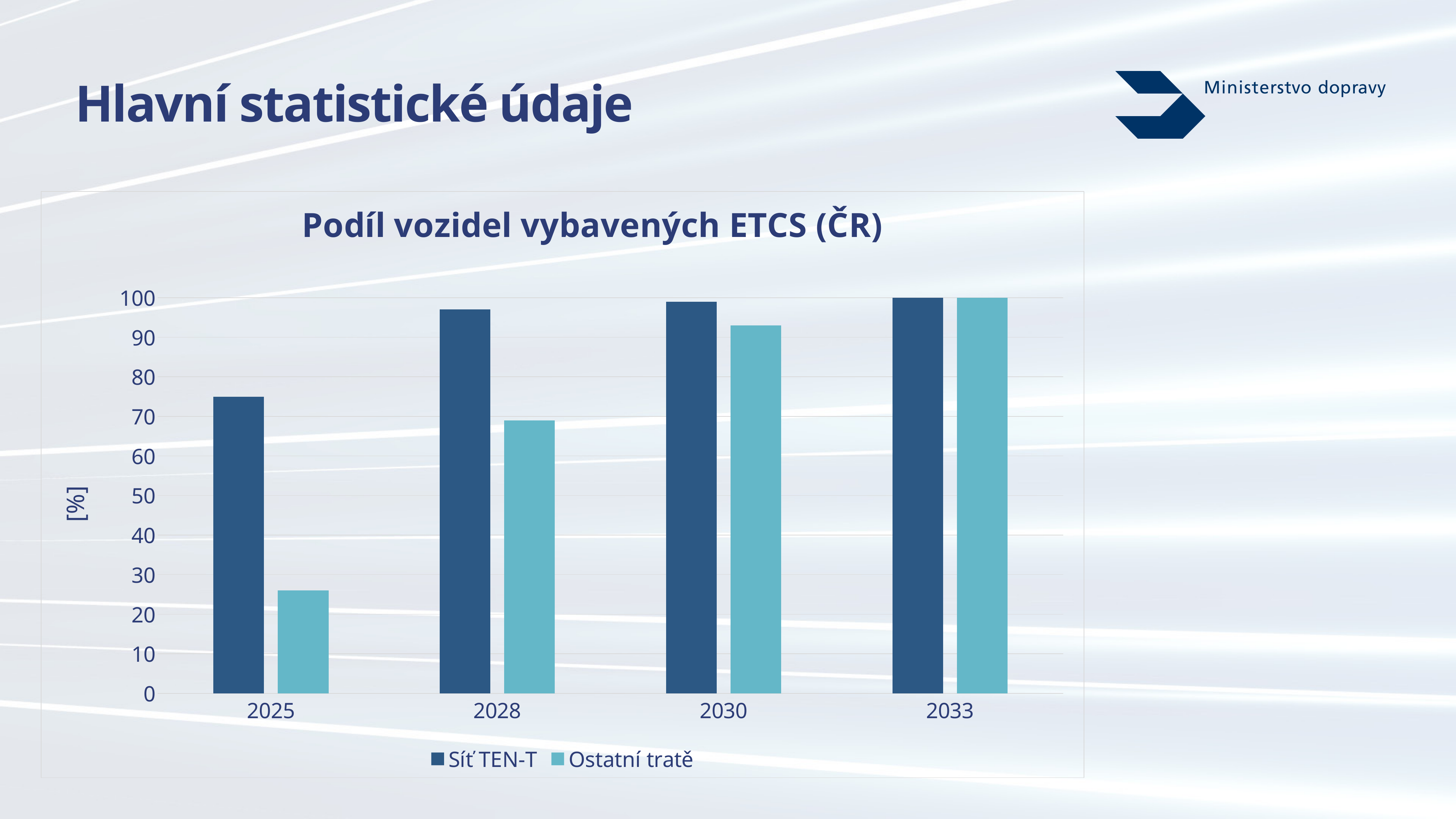
Is the value for Ostatní tratě in 2025 greater or less than 30? less How many series does the legend list? 2 What is the value for Ostatní tratě in 2033? 100 Is the value for Ostatní tratě in 2028 greater or less than 60? greater Do the values for Ostatní tratě rise or fall from 2025 to 2033? rise Is the value for Síť TEN-T in 2025 greater or less than 70? greater What is the value for Síť TEN-T in 2033? 100 In which year is the value for Ostatní tratě lowest? 2025 What kind of chart is shown on the slide? bar chart In 2025, which series has the larger value, Síť TEN-T or Ostatní tratě? Síť TEN-T How many years are shown on the x axis? 4